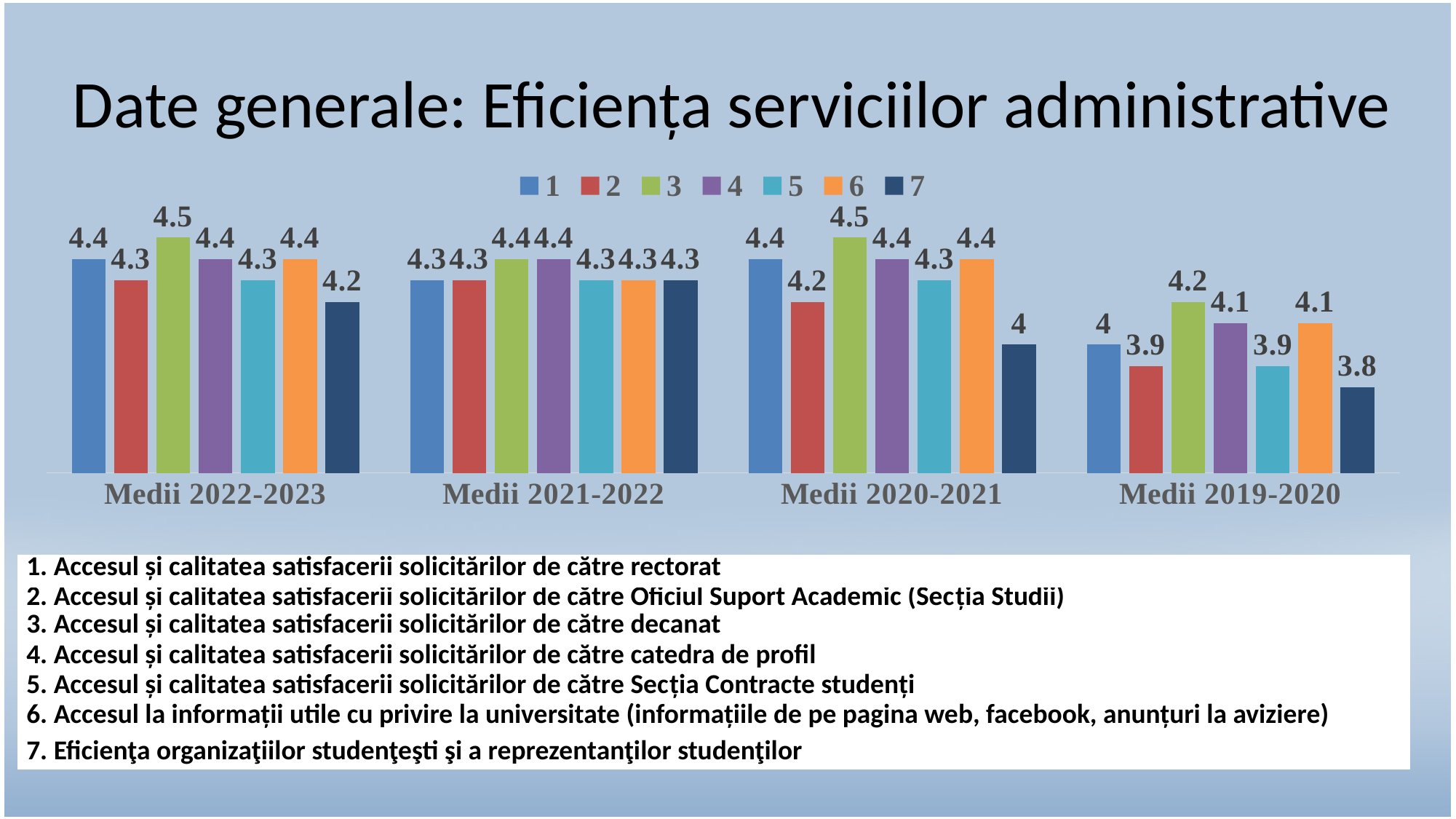
What is the value for series 3 in Medii 2022-2023? 4.5 What is the value for series 2 in Medii 2019-2020? 3.9 Which series has the highest value in Medii 2020-2021? 3 What is the difference between series 3 and series 7 in Medii 2019-2020? 0.4 What is the difference between series 3 and series 7 in Medii 2020-2021? 0.5 How many category groups are shown on the x axis? 4 What is the value for series 6 in Medii 2021-2022? 4.3 How many series does the legend list? 7 Which is larger: series 1 in Medii 2022-2023 or series 1 in Medii 2019-2020? Medii 2022-2023 Which series has the lowest value in Medii 2019-2020? 7 What kind of chart is shown on the slide? Bar chart What is the value for series 7 in Medii 2020-2021? 4